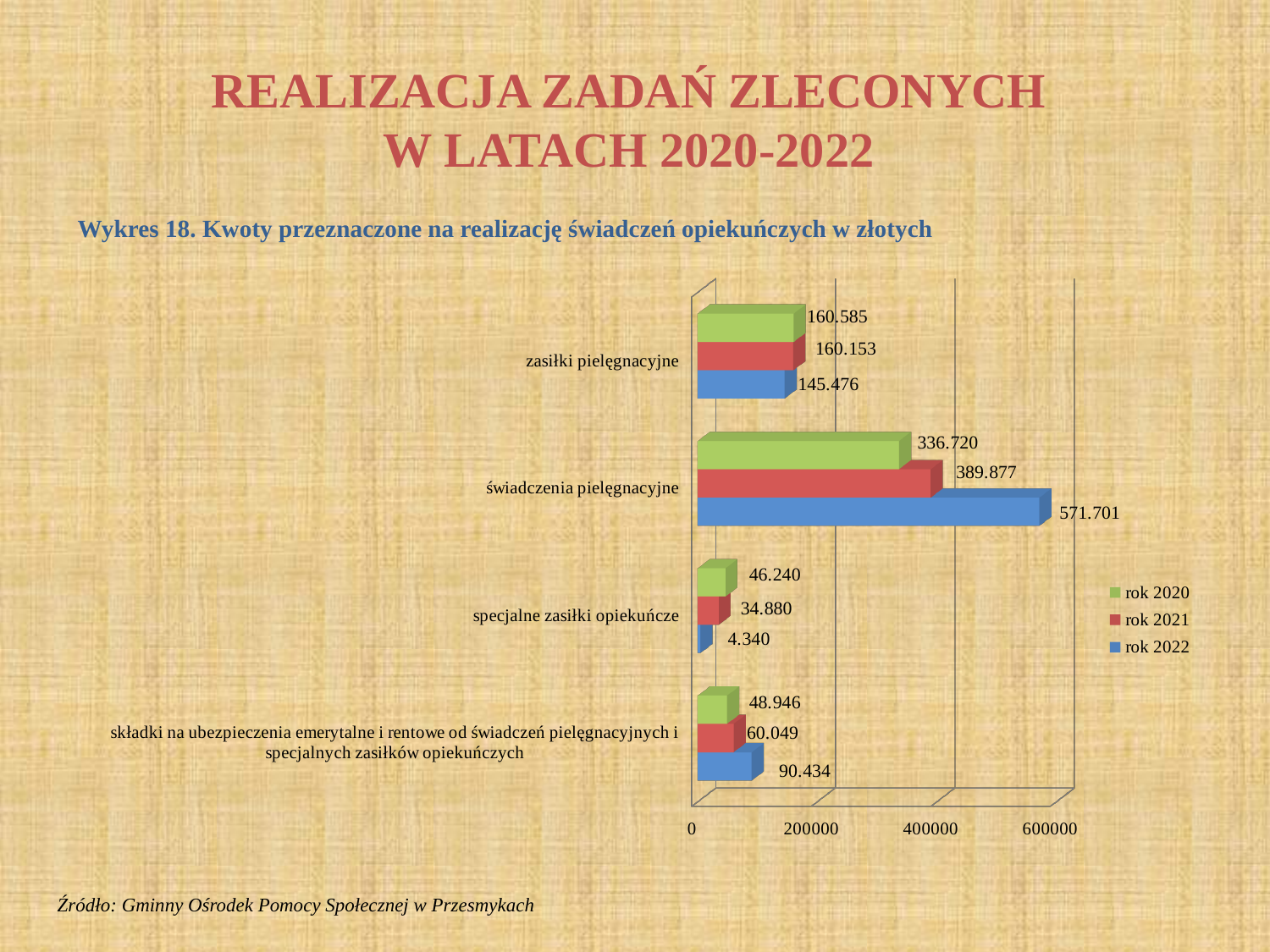
What is the value for zasiłki pielęgnacyjne in rok 2020? 160.585 What type of chart is shown on the slide? bar chart Do the values for składki na ubezpieczenia emerytalne i rentowe rise or fall from rok 2020 to rok 2022? rise What is the value for specjalne zasiłki opiekuńcze in rok 2021? 34.880 Which is larger for specjalne zasiłki opiekuńcze: the rok 2020 value or the rok 2022 value? rok 2020 Which category has the highest value in rok 2022? świadczenia pielęgnacyjne How many series does the legend list? 3 How many categories are shown on the chart? 4 What is the value for świadczenia pielęgnacyjne in rok 2022? 571.701 Which colour represents rok 2021 in the legend? red What is the difference between the rok 2022 and rok 2021 values for świadczenia pielęgnacyjne? 181.824 Which category has the lowest value in rok 2022? specjalne zasiłki opiekuńcze